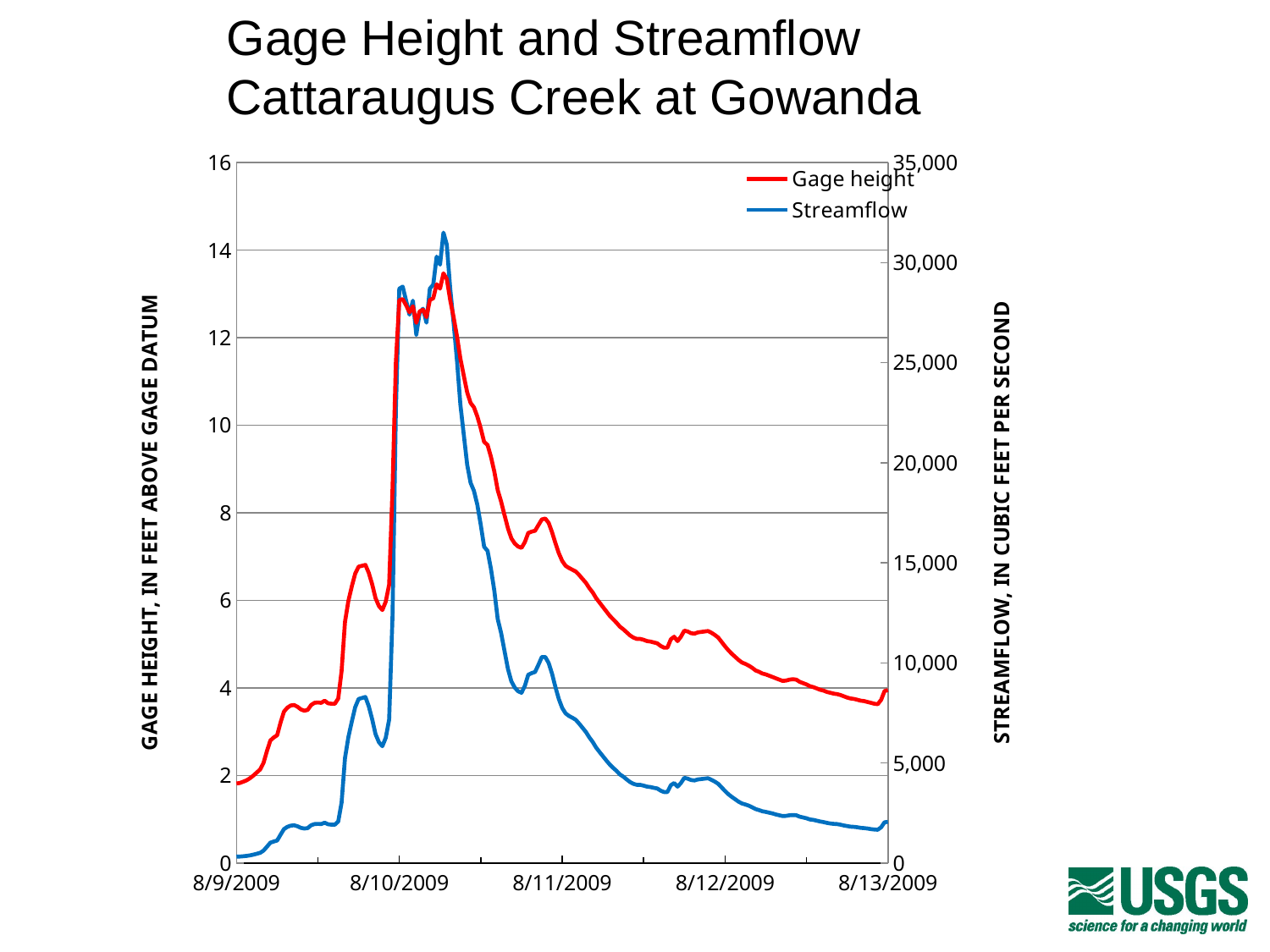
Is the Gage height value at 8/13/2009 greater or less than 6 feet? less Is the Streamflow value at 8/9/2009 greater or less than 5,000 cubic feet per second? less Between 8/11/2009 and 8/13/2009, does the Gage height line rise or fall? fall What is the title of the right-hand vertical axis? STREAMFLOW, IN CUBIC FEET PER SECOND How many dates are labelled along the x axis? 5 Is the peak value of Gage height greater or less than 12 feet? greater Which series is drawn in red? Gage height What kind of chart is shown on the slide? Line chart How many series does the legend list? 2